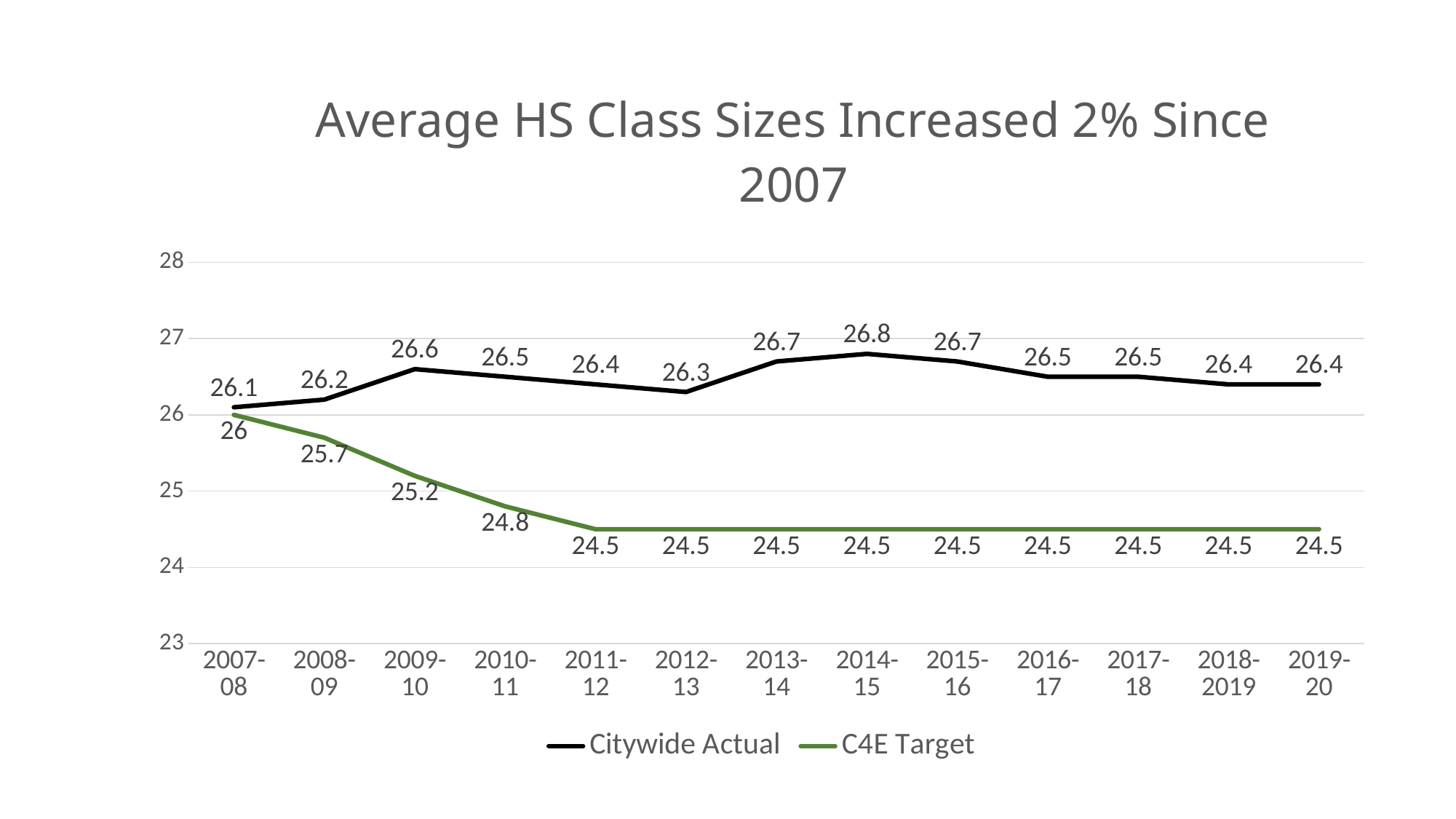
What is the Citywide Actual value for 2007-08? 26.1 Does the C4E Target series rise or fall from 2007-08 to 2011-12? Fall How many series does the legend list? 2 How many school years are shown on the x axis? 13 Which is larger in 2010-11, the Citywide Actual value or the C4E Target value? Citywide Actual What kind of chart is shown on the slide? Line chart In which year is the Citywide Actual value lowest? 2007-08 What is the C4E Target value for 2008-09? 25.7 What is the title of the chart? Average HS Class Sizes Increased 2% Since 2007 In which year is the Citywide Actual value highest? 2014-15 What is the Citywide Actual value for 2014-15? 26.8 What is the difference between the Citywide Actual and C4E Target values in 2019-20? 1.9